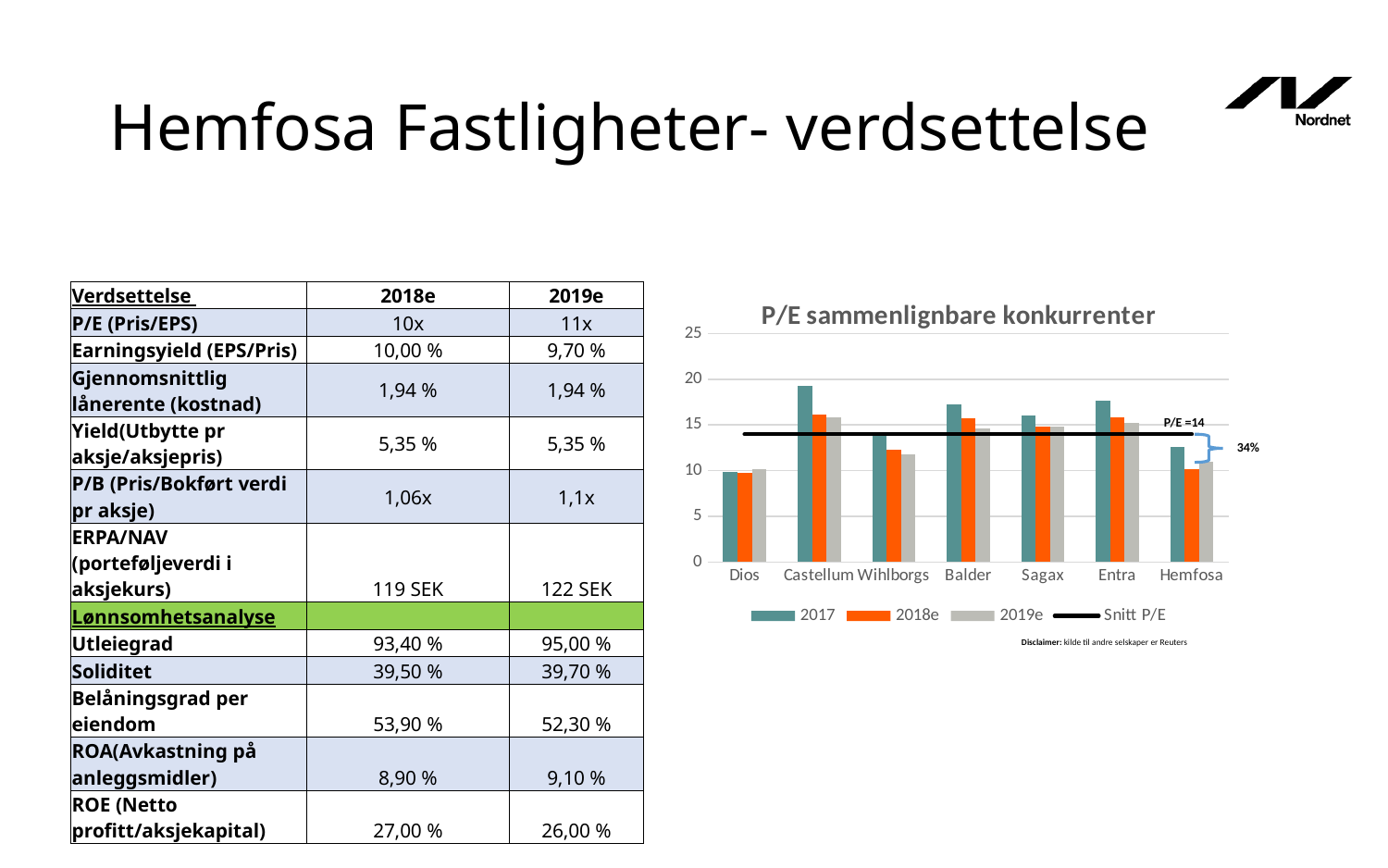
Is the 2018e value for Wihlborgs greater or less than 15? less Which company has the lowest 2017 bar in the chart? Dios What P/E value is the horizontal 'Snitt P/E' line labelled with in the chart? P/E =14 Which is larger in the chart: the 2017 value for Castellum or the 2017 value for Dios? Castellum Is the 2017 value for Entra greater or less than 15? greater How many entries does the chart's legend list? 4 How many companies are shown on the x axis of the chart? 7 Which company has the highest 2017 bar in the chart? Castellum Is the 2017 value for Hemfosa greater or less than 15? less What kind of chart is shown on the slide? combination bar and line chart What is the title of the chart? P/E sammenlignbare konkurrenter